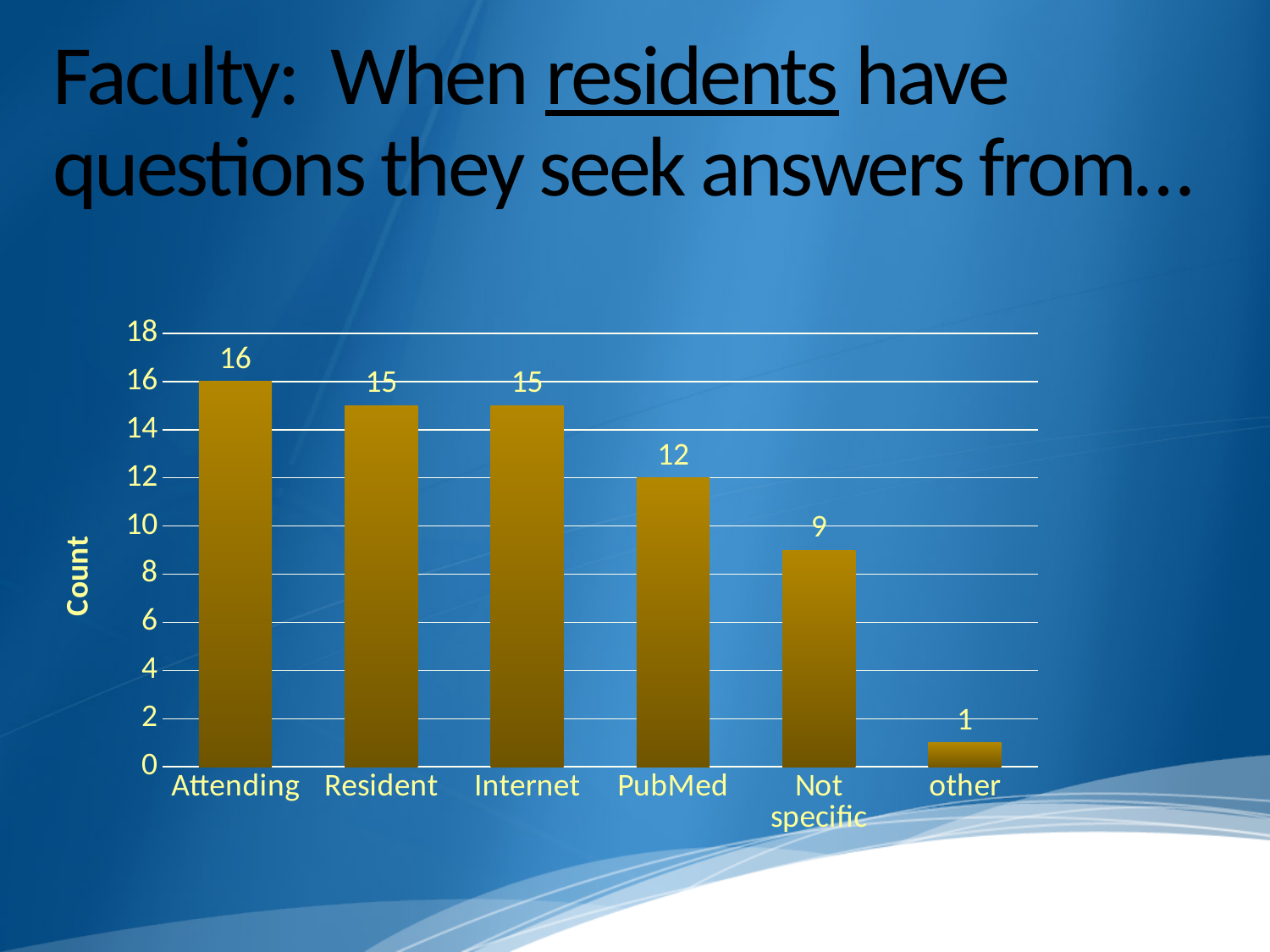
Which category has the highest count? Attending How many categories are shown on the x axis? 6 Which has a larger count, Internet or PubMed? Internet What kind of chart is shown on the slide? Bar chart What is the count for Not specific? 9 Which category has the lowest count? other What is the difference between the counts for Attending and PubMed? 4 What is the label of the vertical axis? Count Do the counts generally rise or fall from left to right along the x axis? Fall What is the difference between the counts for Not specific and other? 8 What is the count for Attending? 16 What is the count for PubMed? 12